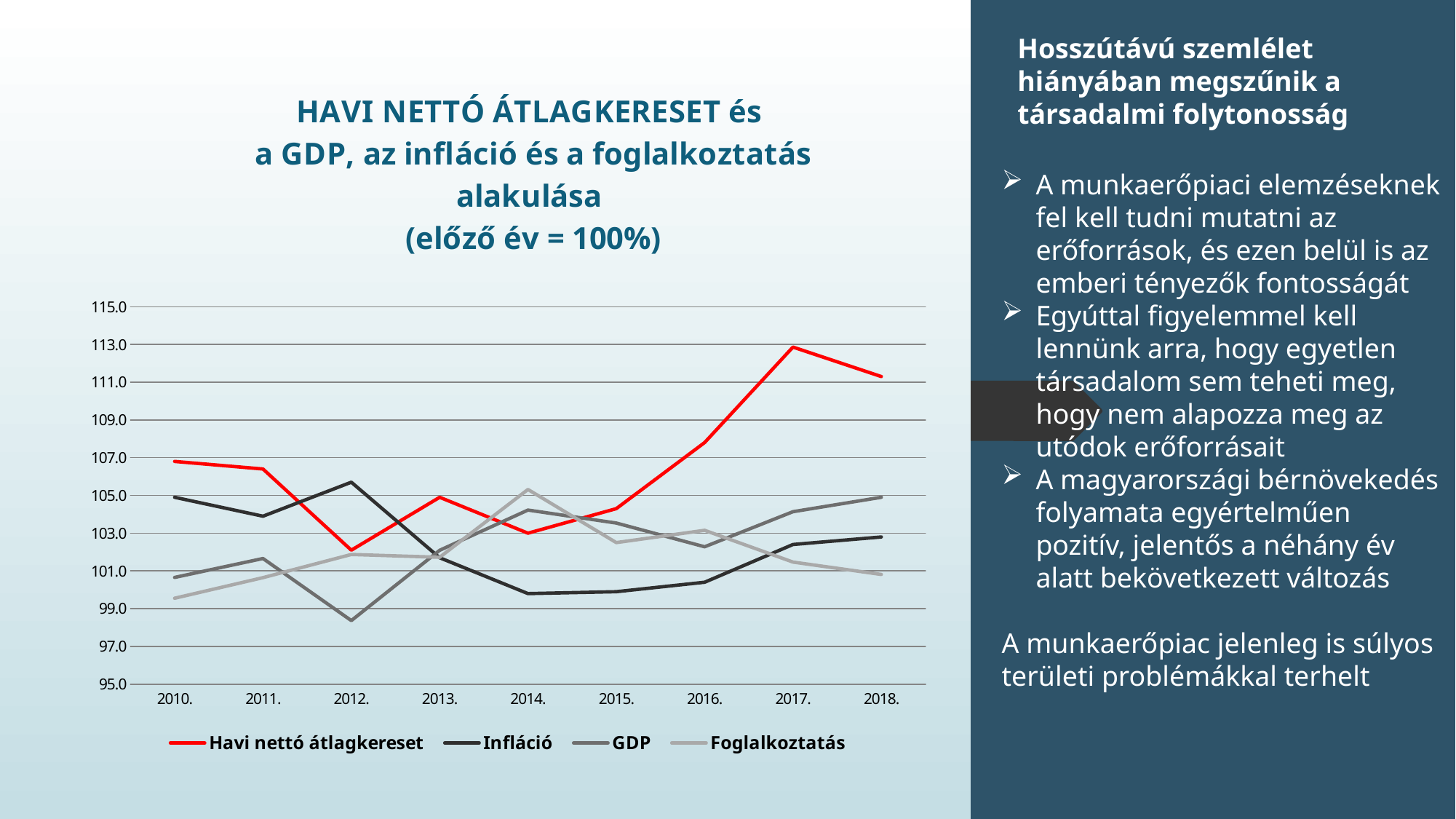
In which year does the Foglalkoztatás series reach its highest value? 2014. In 2017, which is larger: Havi nettó átlagkereset or Infláció? Havi nettó átlagkereset What kind of chart is shown on the slide? line chart Does the Havi nettó átlagkereset series rise or fall from 2015 to 2017? rise In which year does the Havi nettó átlagkereset series reach its lowest value? 2012. How many series does the legend list? 4 How many years are shown on the x axis? 9 In which year does the GDP series reach its lowest value? 2012. Is the value for GDP in 2012 greater or less than 99.0? less Is the value for Infláció in 2014 greater or less than 101.0? less In which year does the Havi nettó átlagkereset series reach its highest value? 2017. Is the value for Havi nettó átlagkereset in 2017 greater or less than 111.0? greater